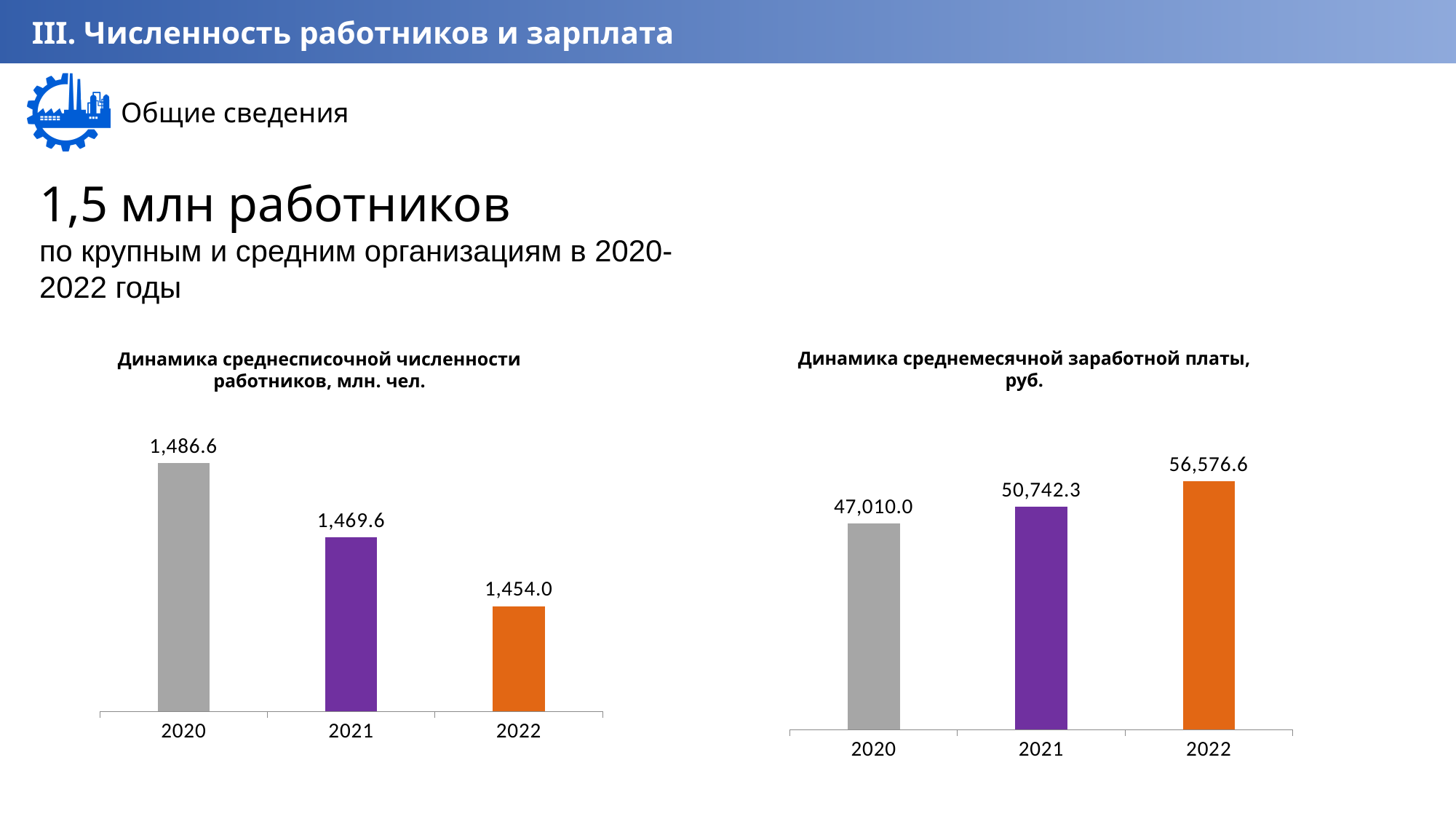
How many years are shown in the right chart (Динамика среднемесячной заработной платы)? 3 In the left chart (Динамика среднесписочной численности работников), do the values rise or fall from 2020 to 2022? fall In the right chart (Динамика среднемесячной заработной платы), which year has the lowest value? 2020 What kind of chart is the left chart (Динамика среднесписочной численности работников)? bar chart In the left chart (Динамика среднесписочной численности работников), what is the value for 2022? 1,454.0 In the right chart (Динамика среднемесячной заработной платы), which is larger, the value for 2021 or the value for 2020? 2021 In the left chart (Динамика среднесписочной численности работников), what is the difference between the 2020 and 2022 values? 32.6 In the right chart (Динамика среднемесячной заработной платы), what is the value for 2021? 50,742.3 In the right chart (Динамика среднемесячной заработной платы), what is the difference between the 2022 and 2020 values? 9,566.6 In the right chart (Динамика среднемесячной заработной платы), what is the value for 2022? 56,576.6 In the left chart (Динамика среднесписочной численности работников), which year has the highest value? 2020 In the left chart (Динамика среднесписочной численности работников), what is the value for 2020? 1,486.6